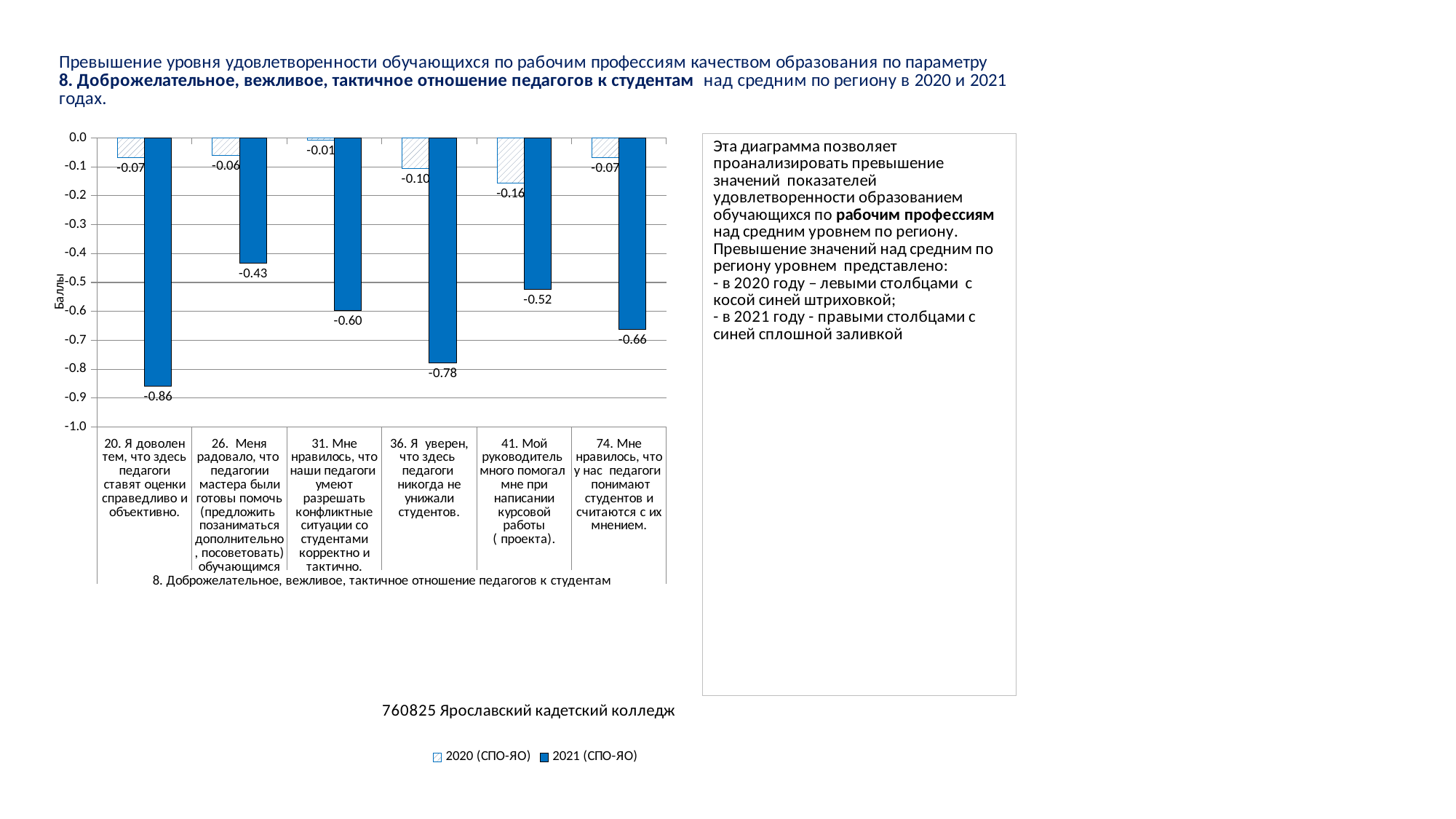
What is the 2021 (СПО-ЯО) value for category 36 ("Я уверен, что здесь педагоги никогда не унижали студентов")? -0.78 What type of chart is shown on the slide? Bar chart What is the 2021 (СПО-ЯО) value for category 20 ("Я доволен тем, что здесь педагоги ставят оценки справедливо и объективно")? -0.86 What is the difference between the 2020 and 2021 (СПО-ЯО) values for category 74 ("Мне нравилось, что у нас педагоги понимают студентов")? 0.59 What is the label of the vertical axis of the chart? Баллы Which category has the lowest 2021 (СПО-ЯО) value? 20. Я доволен тем, что здесь педагоги ставят оценки справедливо и объективно. Which is larger, the 2021 (СПО-ЯО) value for category 26 or for category 31? Category 26 (-0.43) What is the 2020 (СПО-ЯО) value for category 41 ("Мой руководитель много помогал мне при написании курсовой работы")? -0.16 Which category has the highest 2021 (СПО-ЯО) value? 26. Меня радовало, что педагогии мастера были готовы помочь What is the 2020 (СПО-ЯО) value for category 31 ("Мне нравилось, что наши педагоги умеют разрешать конфликтные ситуации")? -0.01 How many categories are shown on the x axis of the chart? 6 How many series does the chart legend list? 2